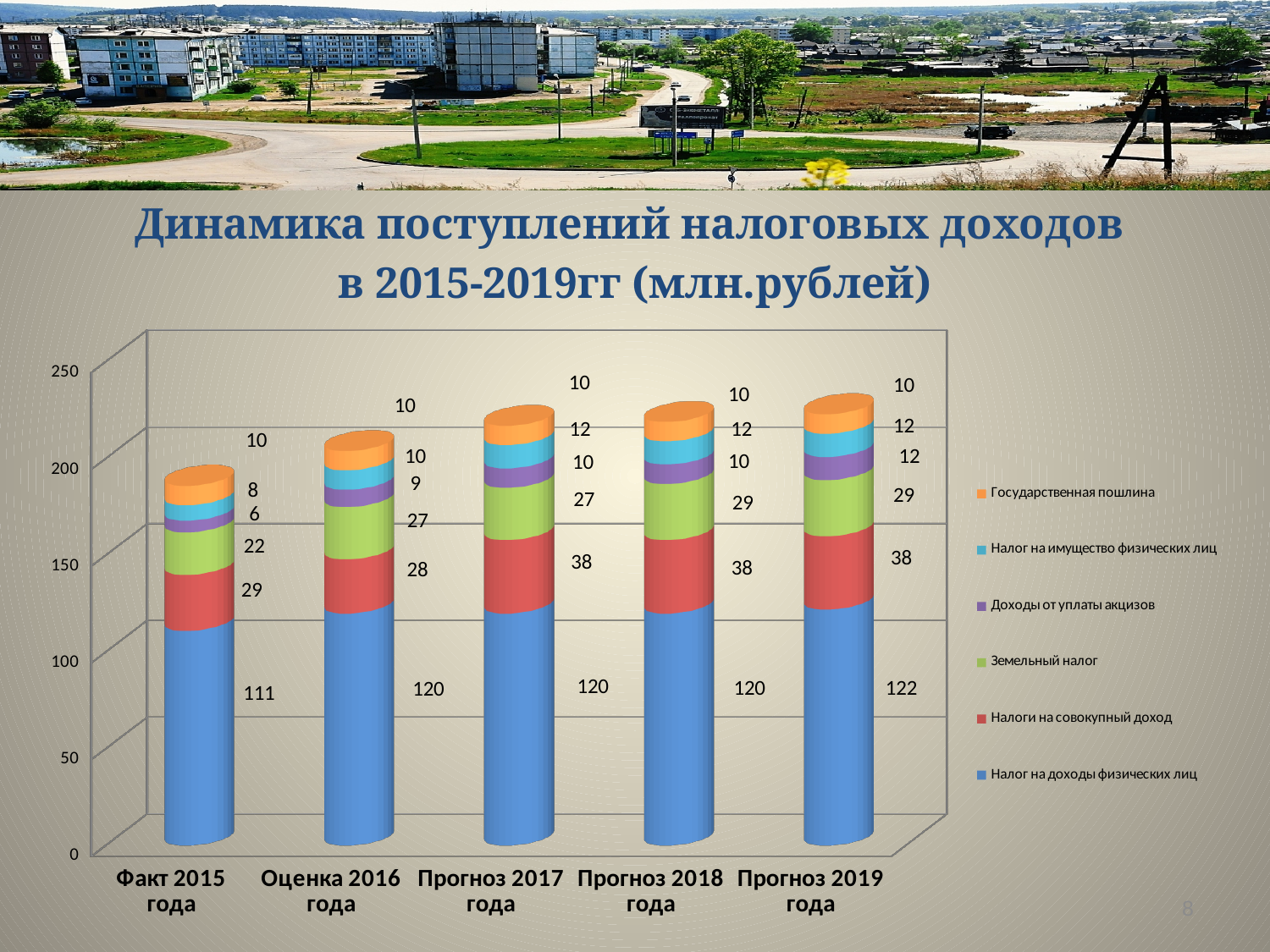
What is the value of Земельный налог for Оценка 2016 года? 27 What is the difference between Налоги на совокупный доход for Прогноз 2017 года and Факт 2015 года? 9 Which category has the lowest value for Земельный налог? Факт 2015 года Which category has the highest value for Налог на доходы физических лиц? Прогноз 2019 года What kind of chart is shown on the slide? Stacked bar chart How many categories are shown on the x axis? 5 What is the value of Доходы от уплаты акцизов for Факт 2015 года? 6 How many series does the legend list? 6 What is the value of Налоги на совокупный доход for Прогноз 2017 года? 38 What is the value of Налог на доходы физических лиц for Факт 2015 года? 111 What is the total of the stacked bar for Факт 2015 года? 186 Which is larger: Налог на имущество физических лиц for Оценка 2016 года or for Прогноз 2018 года? Прогноз 2018 года